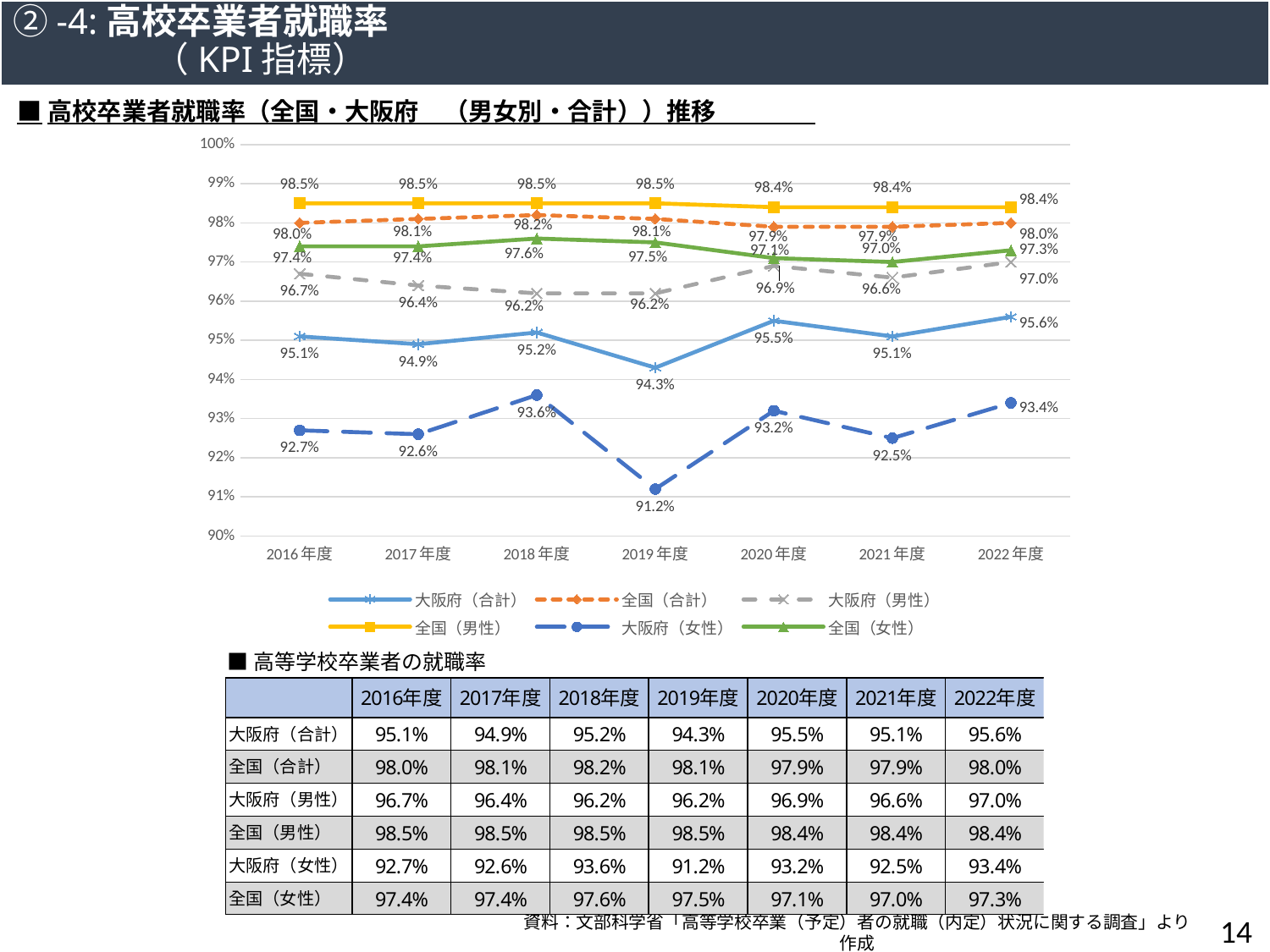
Does the value for 大阪府（女性） rise or fall from 2018年度 to 2019年度? Fall What is the difference between 全国（合計） and 大阪府（合計） in 2022年度? 2.4 percentage points For 大阪府（男性）, which year has the larger value, 2020年度 or 2021年度? 2020年度 What is the value for 大阪府（合計） in 2019年度? 94.3% How many years are shown on the x axis of the chart? 7 What is the value for 全国（男性） in 2016年度? 98.5% Is the value for 大阪府（女性） in 2019年度 greater or less than 92%? less What kind of chart is shown on the slide? Line chart In which year is the value for 大阪府（合計） highest? 2022年度 In which year is the value for 大阪府（女性） lowest? 2019年度 How many series does the legend list? 6 What is the value for 大阪府（女性） in 2018年度? 93.6%